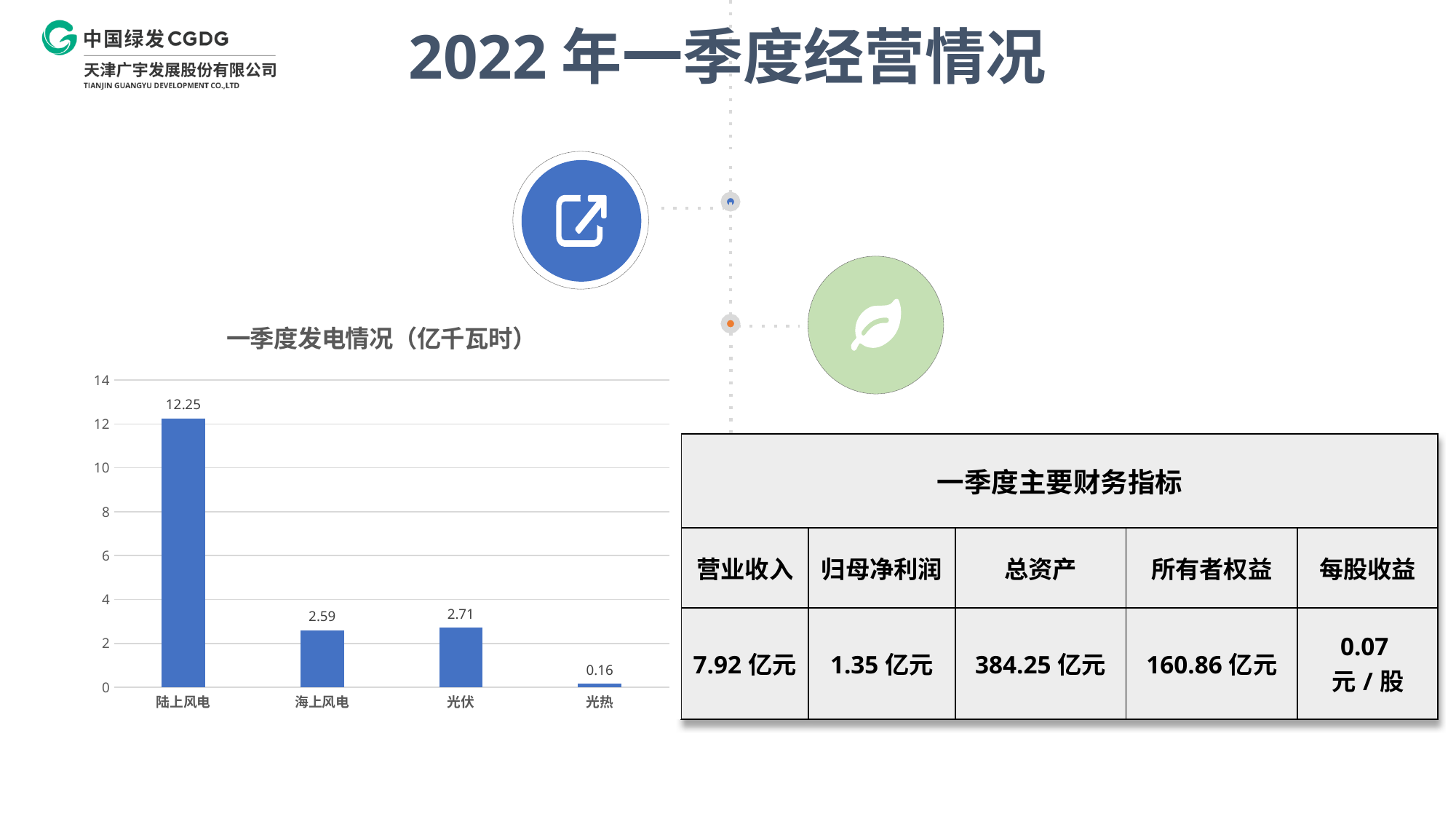
How many categories are shown in the chart? 4 What is the value for 光热 in the chart? 0.16 What is the title of the chart? 一季度发电情况（亿千瓦时） What is the value for 海上风电 in the chart? 2.59 Which category has the lowest value in the chart? 光热 What is the difference between the values for 陆上风电 and 光伏? 9.54 Is the value for 陆上风电 greater or less than 10? greater What is the value for 光伏 in the chart? 2.71 Which is larger, the value for 陆上风电 or the value for 海上风电? 陆上风电 Which category has the highest value in the chart? 陆上风电 What is the difference between the values for 光伏 and 海上风电? 0.12 What is the value for 陆上风电 in the chart? 12.25